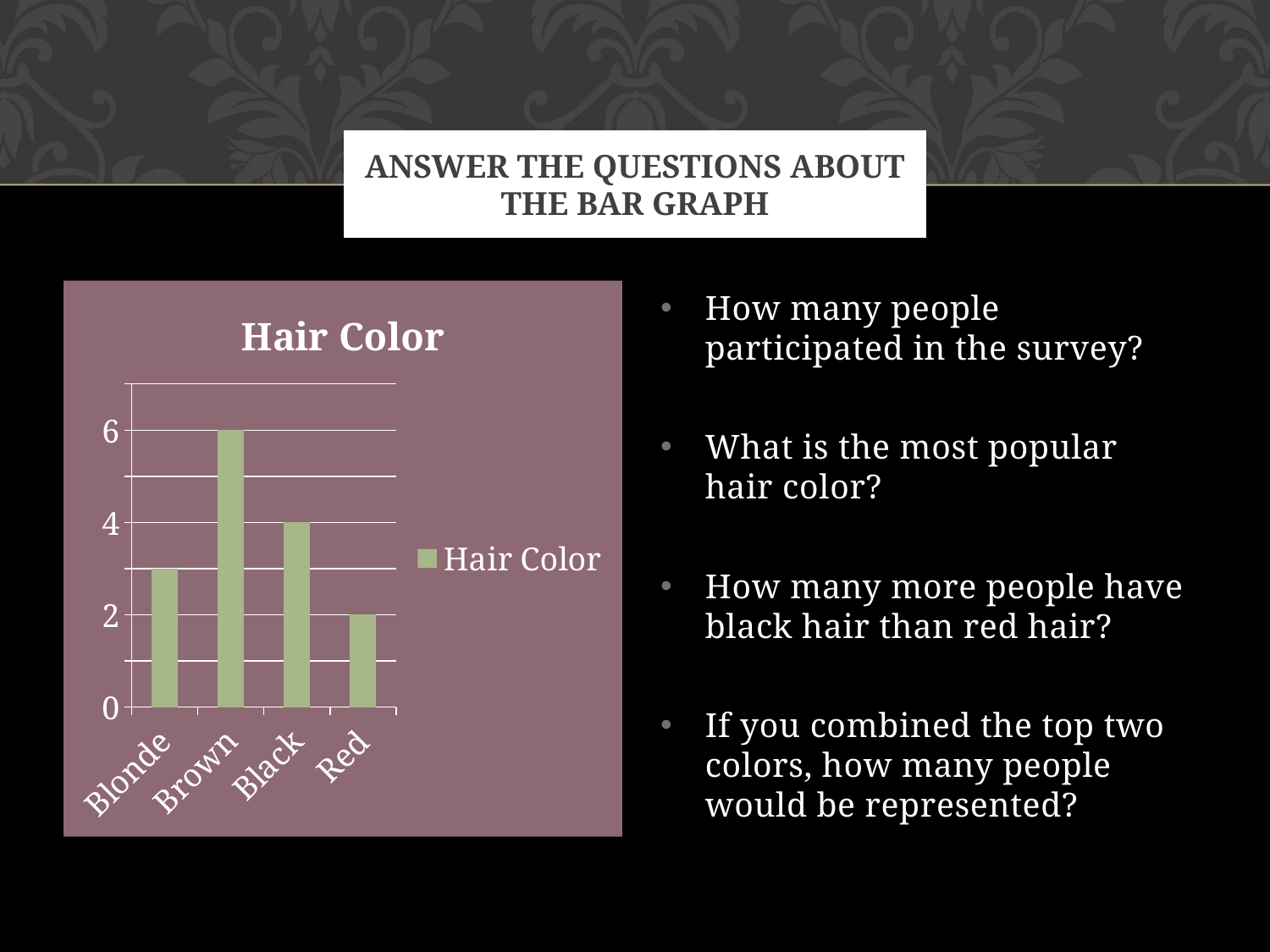
What kind of chart is shown on the slide? bar chart Which hair color has the highest bar in the chart? Brown Is the value for Blonde greater or less than 2? greater Which hair color has the lowest bar in the chart? Red Which is larger in the chart, the value for Brown or the value for Black? Brown What is the value for Brown in the Hair Color chart? 6 What is the value for Red in the Hair Color chart? 2 How many series does the chart's legend list? 1 Is the value for Blonde greater or less than 4? less How many more people have black hair than red hair according to the chart? 2 What is the value for Black in the Hair Color chart? 4 How many hair color categories are shown on the x axis of the chart? 4